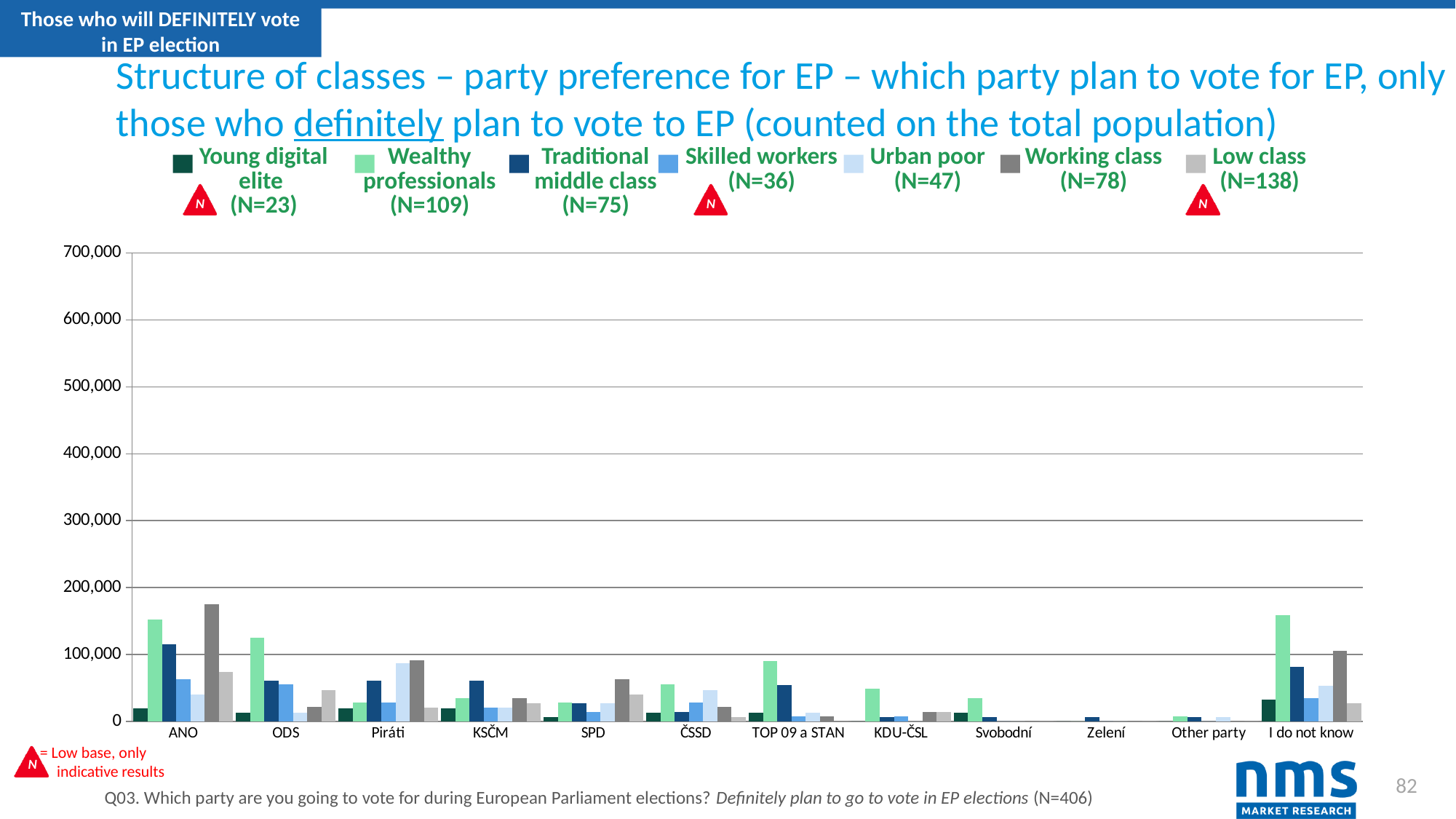
Which party category has the highest Working class bar? ANO How many party categories are shown along the x axis? 12 Is the value for Urban poor in the Piráti category greater or less than 100,000? less Is the value for Wealthy professionals in the 'I do not know' category greater or less than 100,000? greater Is the value for Wealthy professionals in the TOP 09 a STAN category greater or less than 100,000? less How many series does the legend list? 7 What kind of chart is shown on the slide? bar chart Which is larger: the Working class value for ANO or the Working class value for ODS? ANO Within the ODS category, which class has the highest bar? Wealthy professionals What is the sample size (N) shown in the legend for Low class? N=138